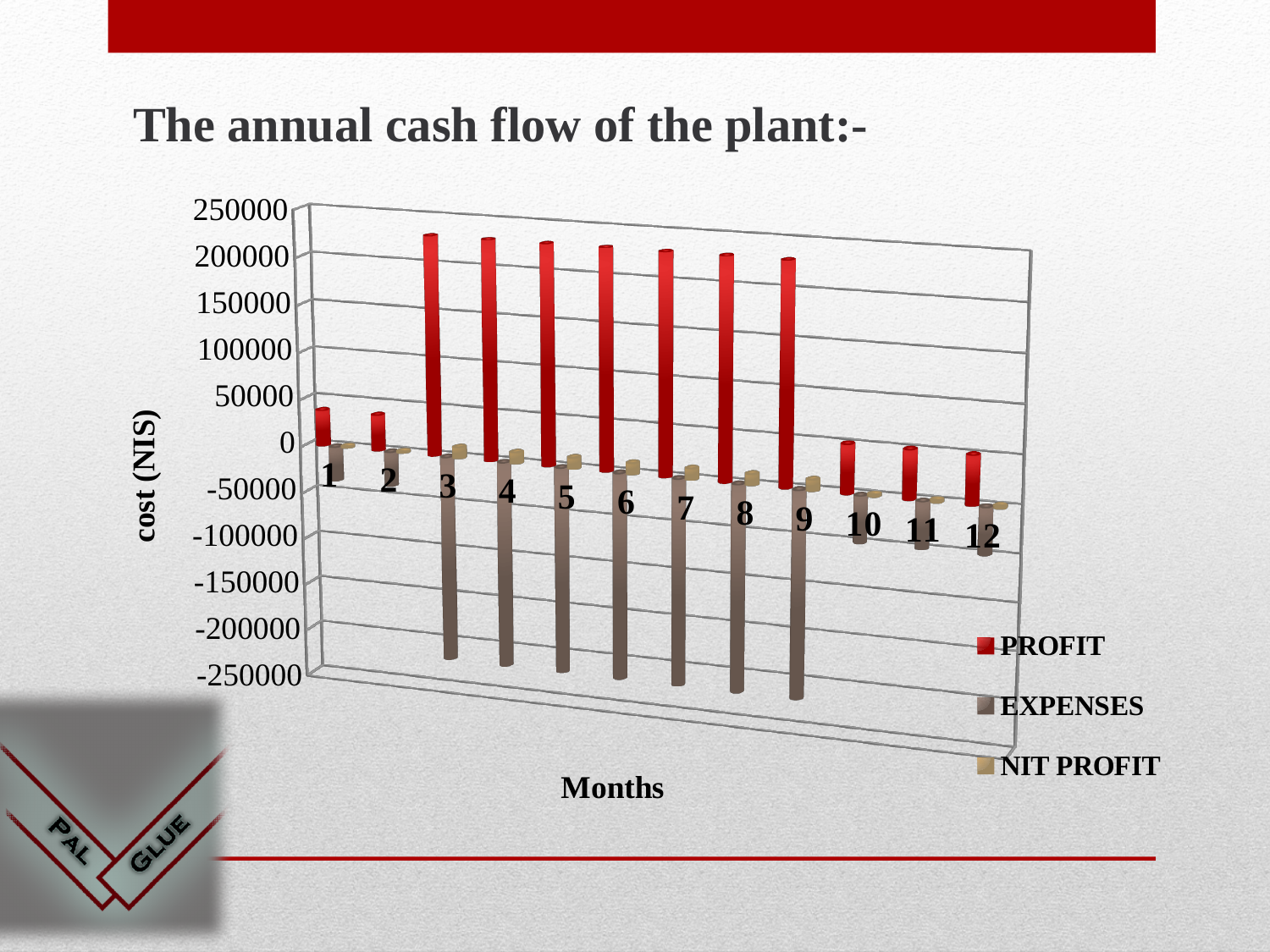
Is the EXPENSES value for month 9 greater or less than -150000? less How many months are plotted along the x axis? 12 What is the title of the vertical axis? cost (NIS) What kind of chart is shown on the slide? bar chart Is the PROFIT value for month 7 greater or less than 100000? greater What are the three series named in the legend? PROFIT, EXPENSES, NIT PROFIT How many series does the legend list? 3 Is the PROFIT value for month 3 greater or less than 150000? greater Which month has the larger PROFIT value, month 3 or month 10? month 3